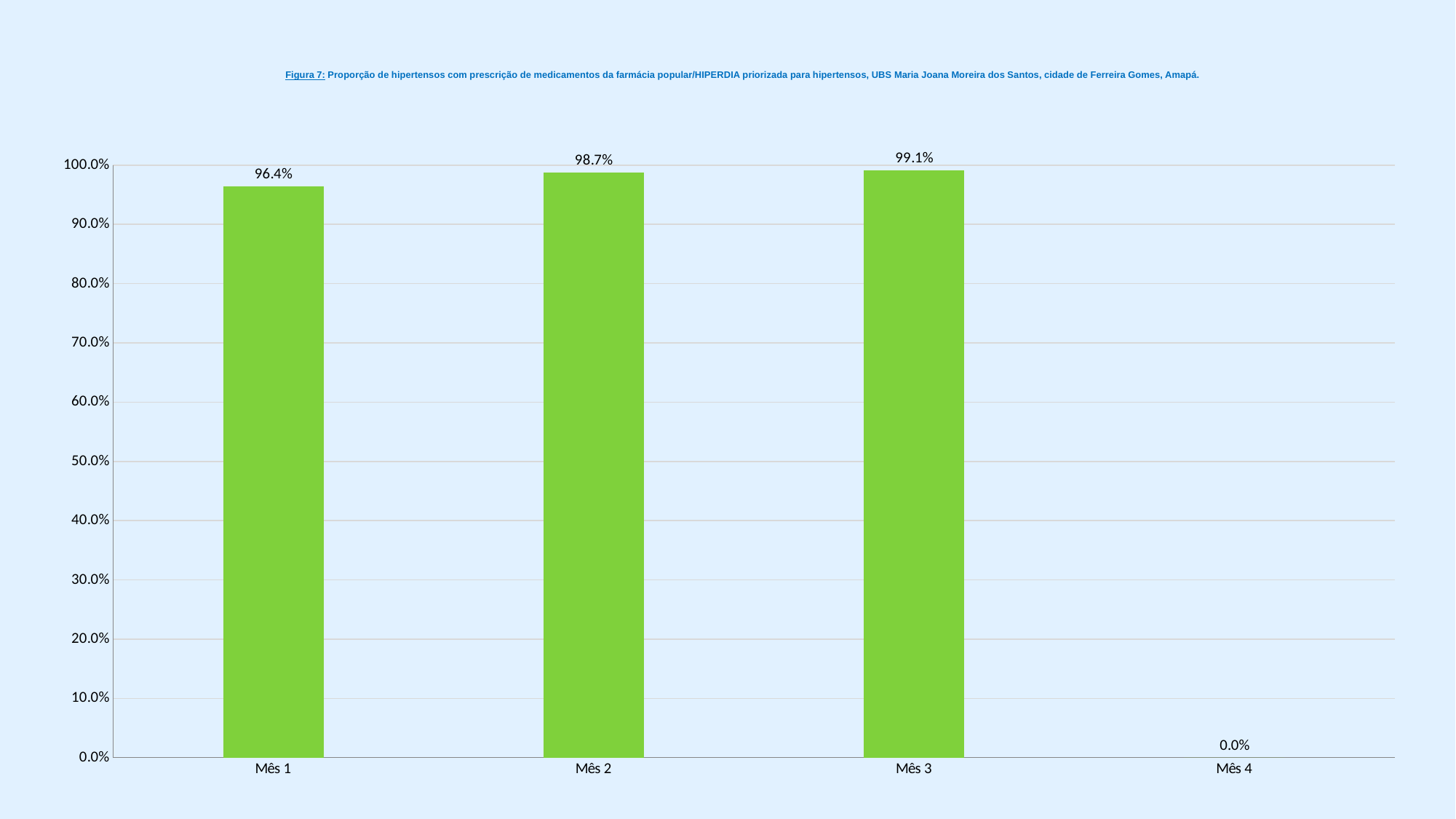
Is the value for Mês 1 greater or less than 90.0%? greater What colour are the bars? Green Which is larger, the value for Mês 1 or the value for Mês 2? Mês 2 What is the value for Mês 1? 96.4% What is the value for Mês 2? 98.7% What is the difference between the values for Mês 2 and Mês 1? 2.3% Which month has the highest value? Mês 3 Which month has the lowest value? Mês 4 How many months are shown on the x axis? 4 What is the value for Mês 3? 99.1% What kind of chart is this? Bar chart What is the value for Mês 4? 0.0%